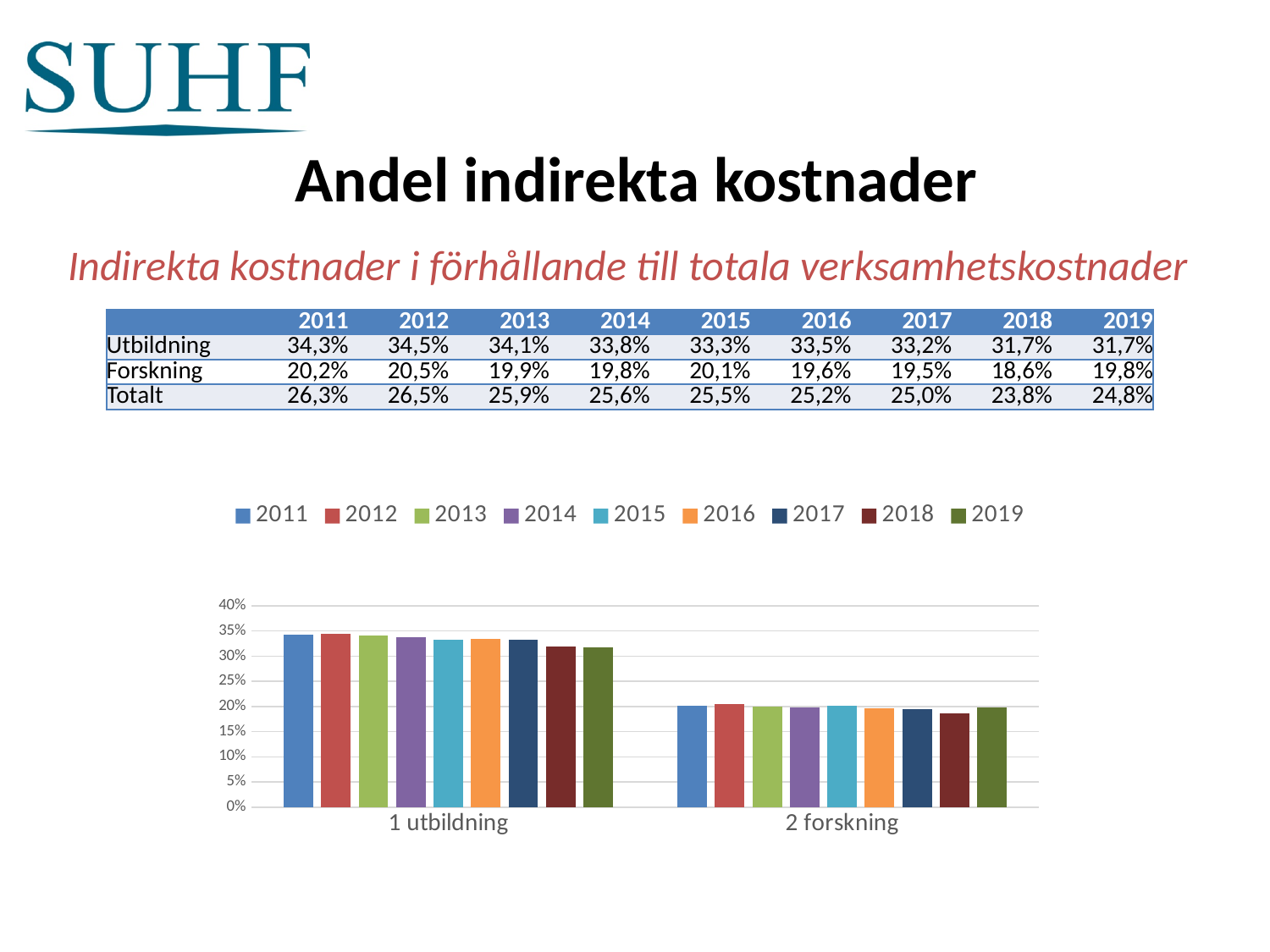
How many categories are shown on the x axis of the chart? 2 For 2015, which category has the taller bar, 1 utbildning or 2 forskning? 1 utbildning From 2011 to 2019, do the bars for 1 utbildning generally rise or fall? fall What kind of chart is shown on the slide? bar chart Is the 2011 bar for 1 utbildning greater or less than 30%? greater According to the table, which year has the highest value for Utbildning? 2012 According to the table, what is the value for Totalt in 2019? 24,8% How many series does the chart legend list? 9 According to the table, what is the value for Utbildning in 2011? 34,3% Is the 2018 bar for 2 forskning greater or less than 20%? less According to the table, what is the value for Forskning in 2018? 18,6% According to the table, which year has the lowest value for Forskning? 2018